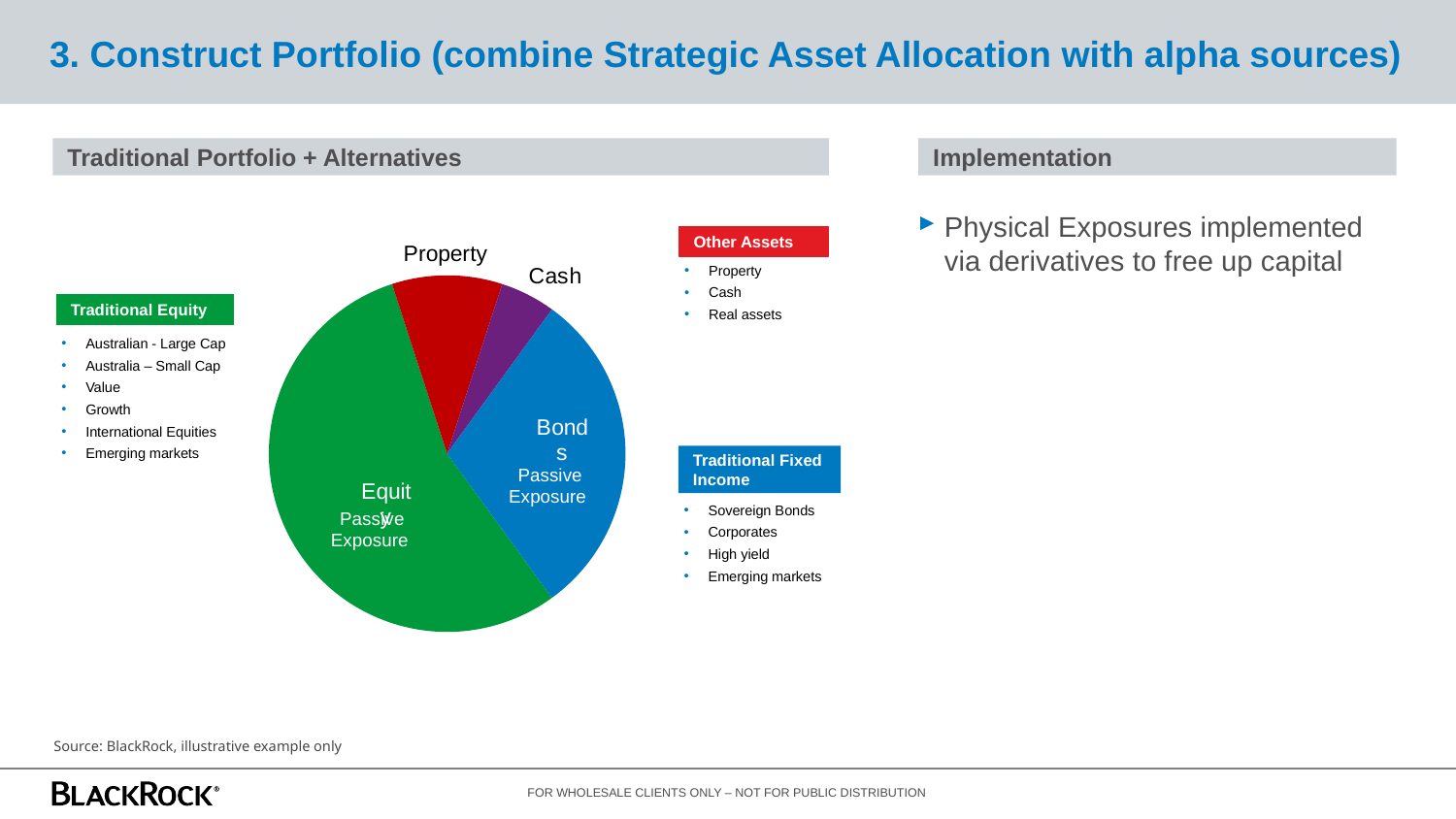
Which slice is larger in the pie chart, Property or Cash? Property Which slice of the pie chart is the second largest? Bonds What colour is the Equity slice of the pie chart? green Which slice is larger in the pie chart, Bonds or Property? Bonds Which slice of the pie chart is the largest? Equity How many slices does the pie chart have? 4 What colour is the Property slice of the pie chart? red Which slice of the pie chart is the smallest? Cash What kind of chart is shown on the slide? pie chart